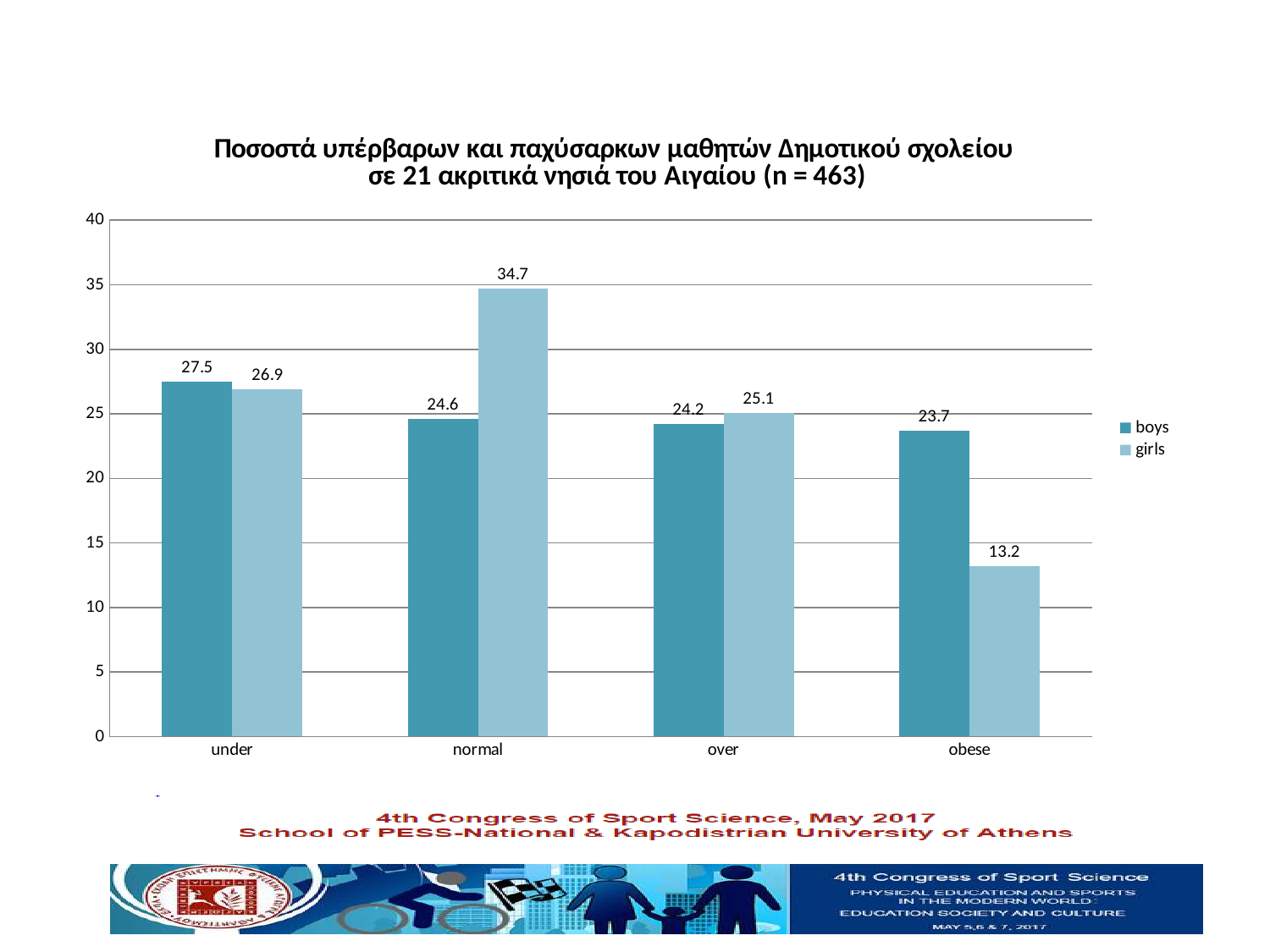
What is the value for boys in the 'under' category? 27.5 In the 'over' category, which is larger, the value for boys or for girls? girls Which category has the highest value for girls? normal What is the difference between the boys and girls values in the 'obese' category? 10.5 Is the value for girls in the 'obese' category greater or less than 15? less What kind of chart is shown on the slide? bar chart What is the difference between the girls and boys values in the 'normal' category? 10.1 How many series does the legend list? 2 Which category has the lowest value for boys? obese What is the value for girls in the 'obese' category? 13.2 How many categories are shown on the x axis? 4 What is the value for girls in the 'normal' category? 34.7